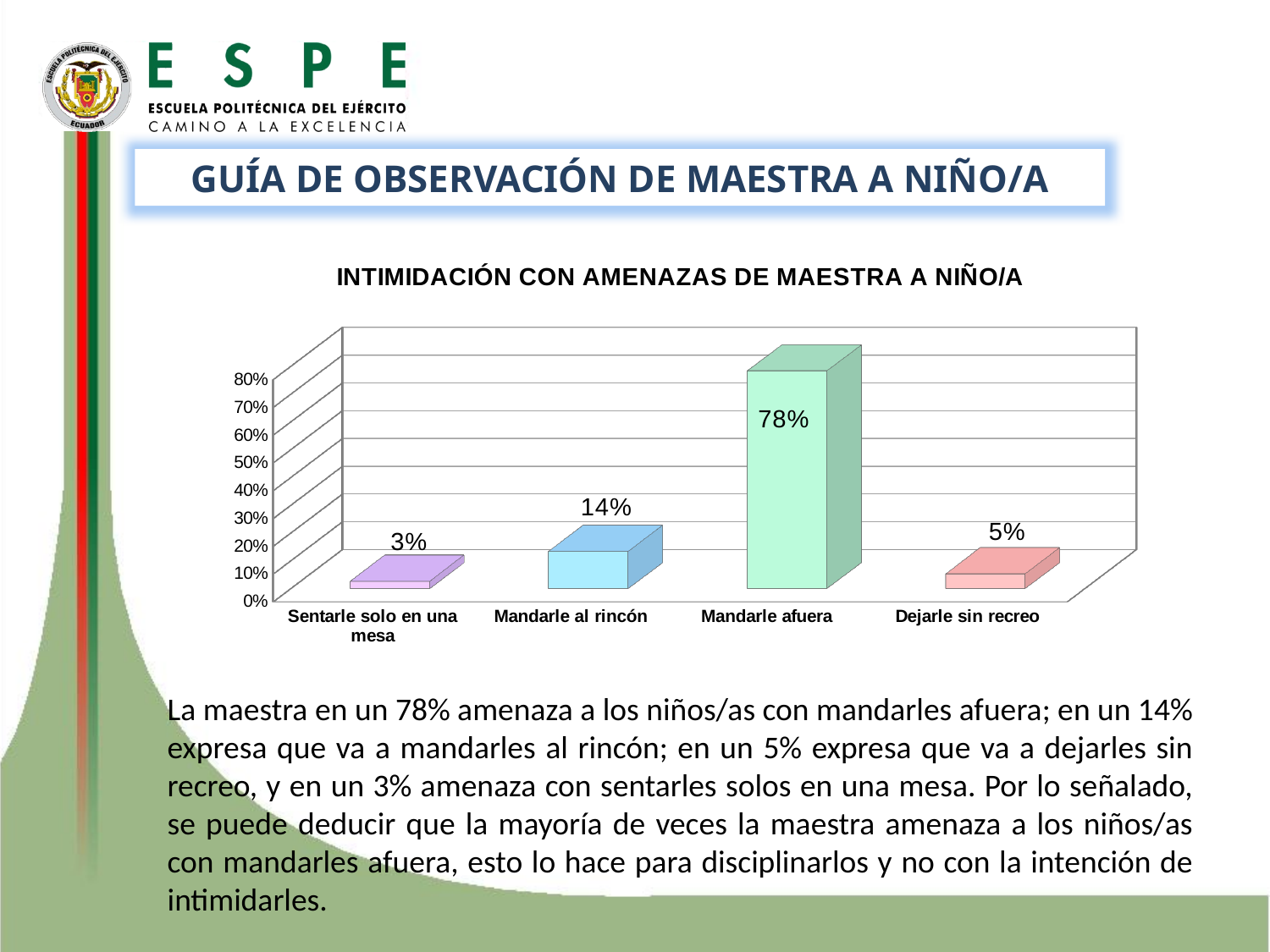
What is the value for "Mandarle afuera"? 78% How many categories are shown on the x axis? 4 Which category has the lowest value? Sentarle solo en una mesa What is the value for "Mandarle al rincón"? 14% Is the value for "Mandarle afuera" greater or less than 50%? greater What is the title of the chart? INTIMIDACIÓN CON AMENAZAS DE MAESTRA A NIÑO/A What is the difference between the values for "Mandarle afuera" and "Mandarle al rincón"? 64% Which category has the highest value? Mandarle afuera Which is larger, the value for "Dejarle sin recreo" or the value for "Sentarle solo en una mesa"? Dejarle sin recreo What is the value for "Sentarle solo en una mesa"? 3% What kind of chart is shown on the slide? Bar chart What is the value for "Dejarle sin recreo"? 5%